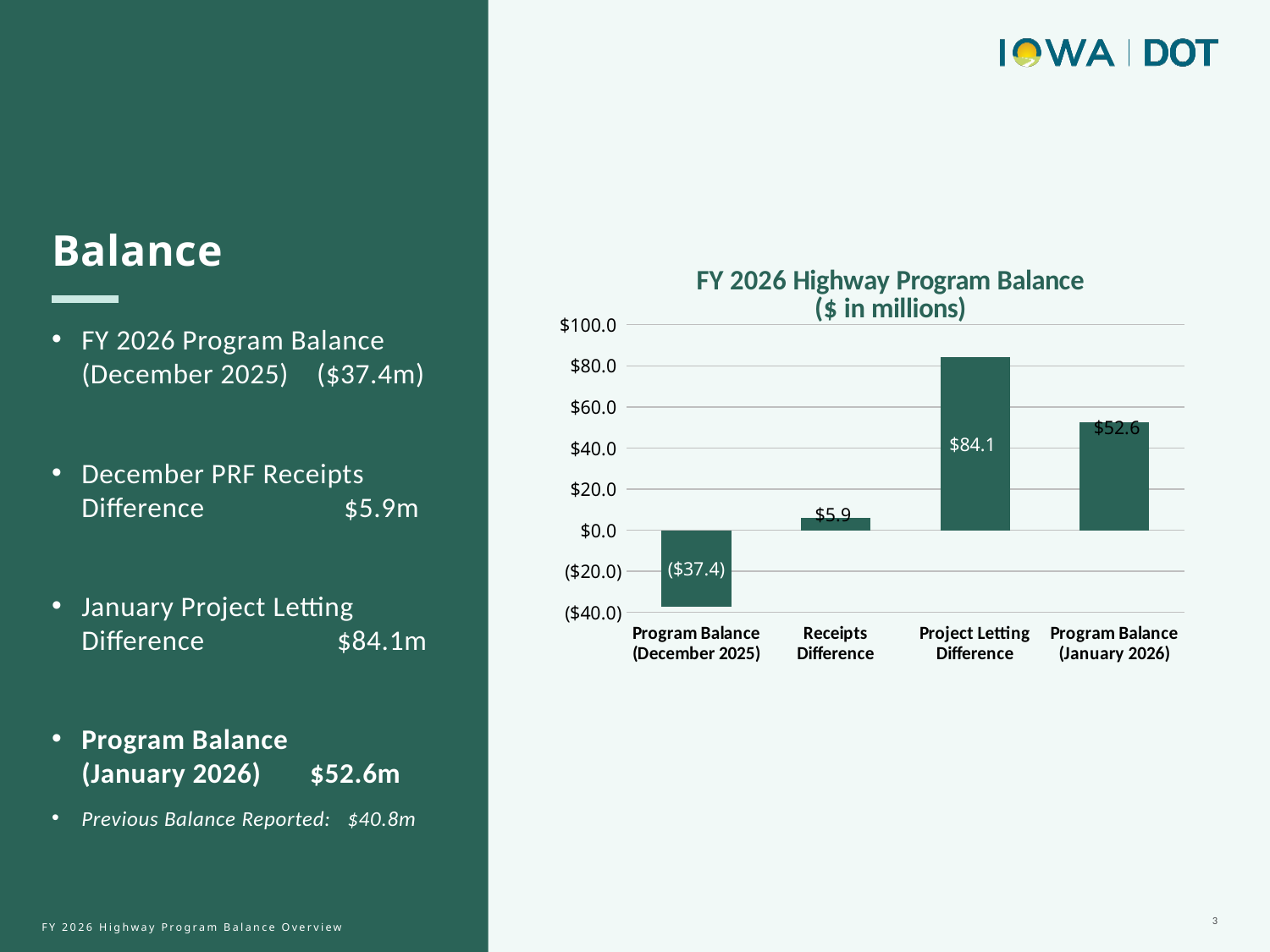
What is the difference between the Project Letting Difference and the Program Balance (January 2026) values? $31.5 What is the title of the chart? FY 2026 Highway Program Balance ($ in millions) What is the value for Project Letting Difference in the chart? $84.1 What is the value for Program Balance (January 2026) in the chart? $52.6 What is the value for Receipts Difference in the chart? $5.9 Is the value for Project Letting Difference greater or less than $80.0? greater Which category has the lowest value in the chart? Program Balance (December 2025) Which is larger, the Receipts Difference or the Program Balance (January 2026)? Program Balance (January 2026) What is the value for Program Balance (December 2025) in the FY 2026 Highway Program Balance chart? ($37.4) How many categories are shown on the x axis of the chart? 4 Which category has the highest value in the chart? Project Letting Difference What kind of chart is shown on the slide? Bar chart